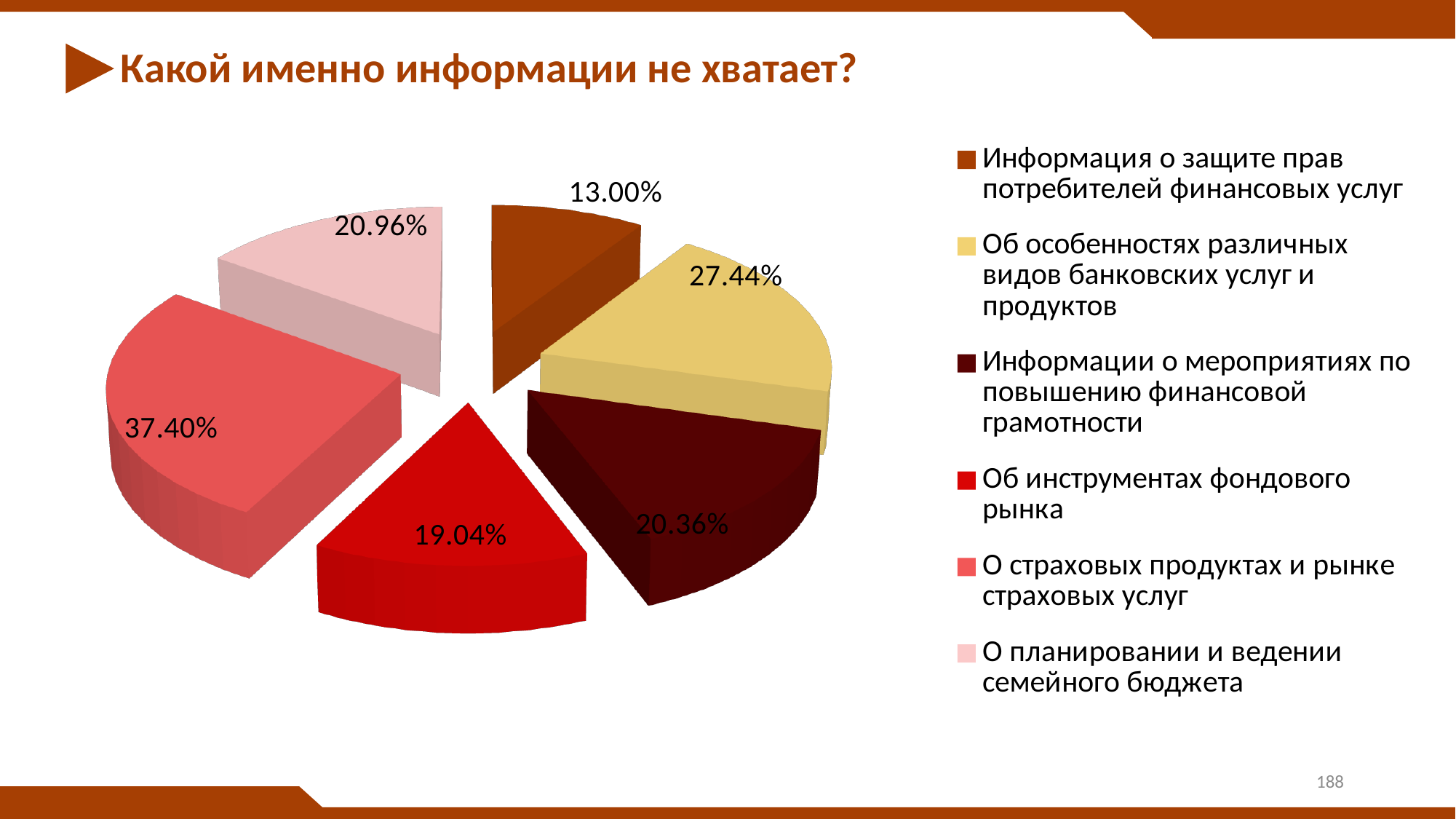
What is the difference between the values for "О страховых продуктах и рынке страховых услуг" and "Информация о защите прав потребителей финансовых услуг"? 24.40% What is the value for "Информация о защите прав потребителей финансовых услуг"? 13.00% What is the title of the slide? Какой именно информации не хватает? What is the value for "О планировании и ведении семейного бюджета"? 20.96% What is the value for "Об особенностях различных видов банковских услуг и продуктов"? 27.44% Which is larger: the value for "Информации о мероприятиях по повышению финансовой грамотности" or for "Об инструментах фондового рынка"? Информации о мероприятиях по повышению финансовой грамотности Which category has the smallest slice? Информация о защите прав потребителей финансовых услуг What is the value for "Об инструментах фондового рынка"? 19.04% Which category has the largest slice? О страховых продуктах и рынке страховых услуг How many categories does the pie chart have? 6 What kind of chart is shown on the slide? Pie chart What is the value for "О страховых продуктах и рынке страховых услуг"? 37.40%